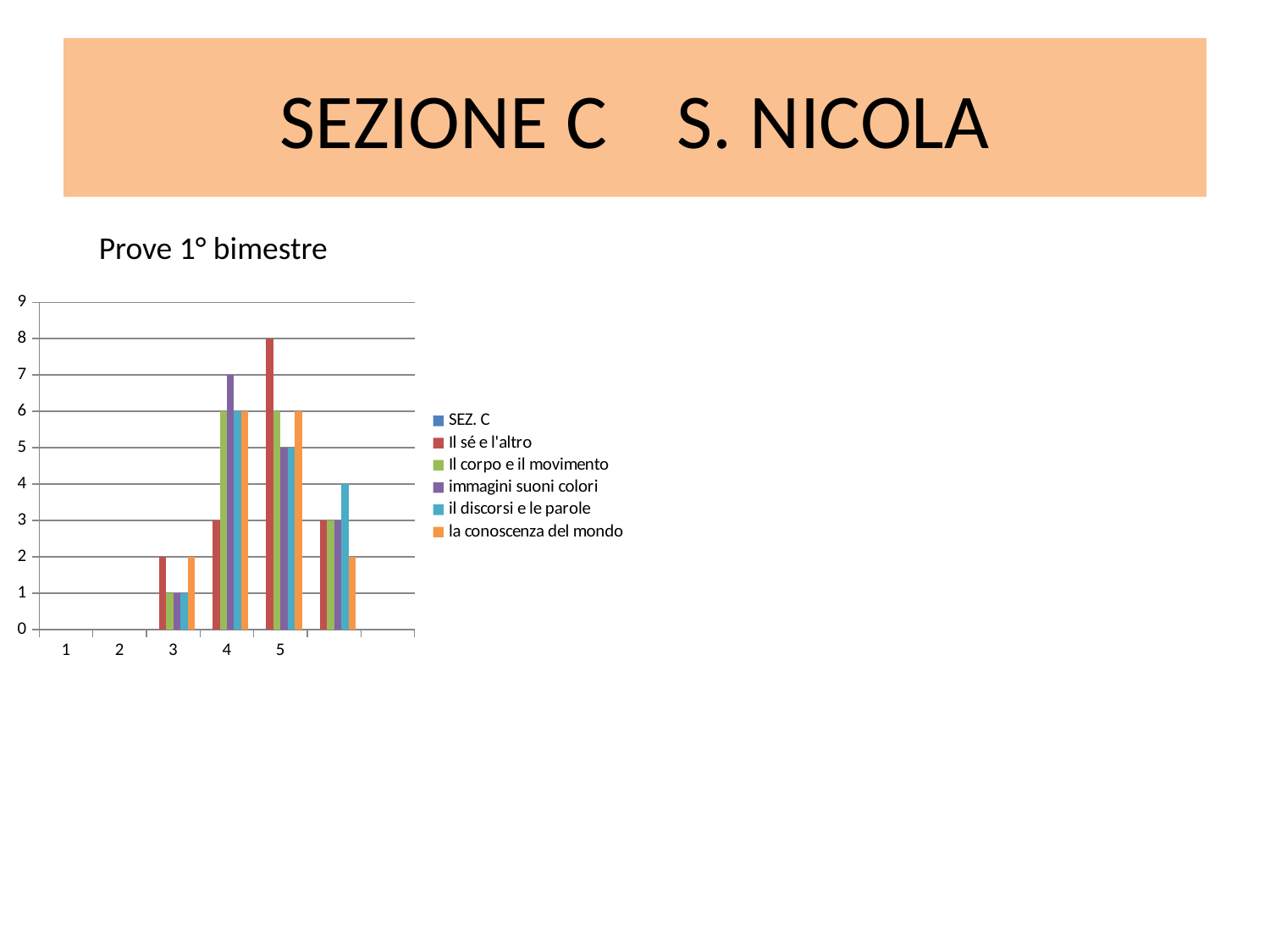
Is the value of 'immagini suoni colori' for category 4 greater or less than 5? greater What is the value of 'il discorsi e le parole' for category 5? 5 Which category has the lowest value for 'Il corpo e il movimento'? 3 What is the value of 'Il sé e l'altro' for category 5? 8 What is the title of the chart? Prove 1° bimestre For category 4, which is larger: 'Il sé e l'altro' or 'Il corpo e il movimento'? Il corpo e il movimento What kind of chart is shown on the slide? bar chart What is the difference between the 'Il sé e l'altro' values for category 5 and category 4? 5 What is the value of 'la conoscenza del mondo' for category 3? 2 Which category has the highest value for 'Il sé e l'altro'? 5 What is the value of 'immagini suoni colori' for category 4? 7 How many series does the legend list? 6